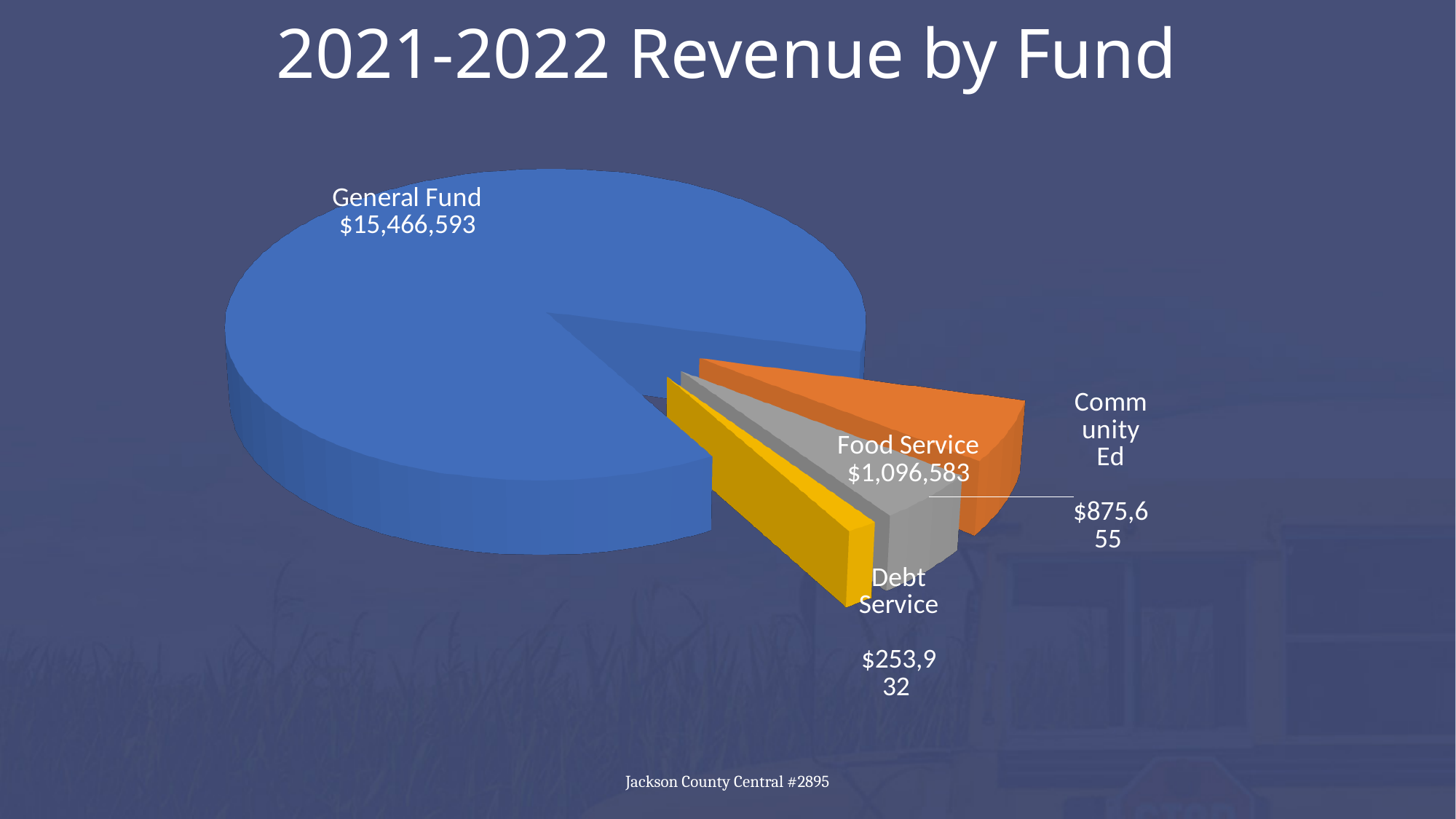
What is the revenue for Debt Service? $253,932 What is the revenue for the General Fund? $15,466,593 Which has more revenue, Food Service or Debt Service? Food Service What is the difference between the Community Ed and Debt Service revenues? $621,723 Which fund has the lowest revenue? Debt Service How much more revenue does Food Service have than Community Ed? $220,928 What type of chart is shown on the slide? Pie chart What is the revenue for Community Ed? $875,655 How many funds are shown in the pie chart? 4 What is the title of the chart? 2021-2022 Revenue by Fund Which fund has the highest revenue? General Fund What is the revenue for Food Service? $1,096,583